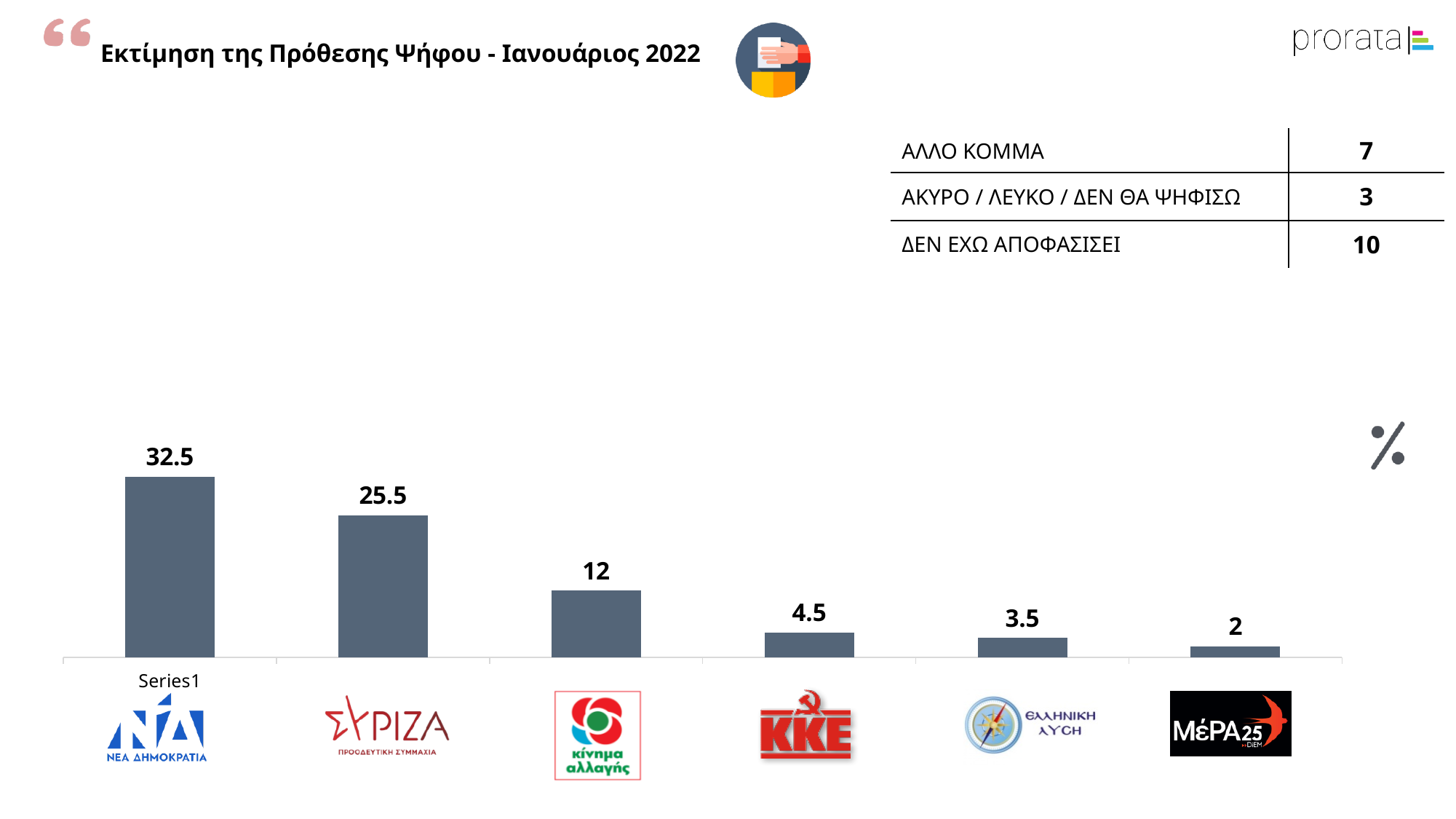
Which party has the lowest bar in the chart? ΜέΡΑ25 What is the value of the bar above the ΣΥΡΙΖΑ logo? 25.5 How many bars does the chart show? 6 What is the difference between the ΝΕΑ ΔΗΜΟΚΡΑΤΙΑ bar and the ΣΥΡΙΖΑ bar? 7 Which party has the highest bar in the chart? ΝΕΑ ΔΗΜΟΚΡΑΤΙΑ What is the value of the bar above the ΝΕΑ ΔΗΜΟΚΡΑΤΙΑ logo? 32.5 What is the value of the bar above the ΚΚΕ logo? 4.5 Which is larger, the ΚΚΕ bar or the Ελληνική Λύση bar? ΚΚΕ What is the value of the bar above the Κίνημα Αλλαγής logo? 12 Do the bar values rise or fall from left to right across the chart? fall What is the value of the bar above the ΜέΡΑ25 logo? 2 What type of chart is shown on the slide? bar chart